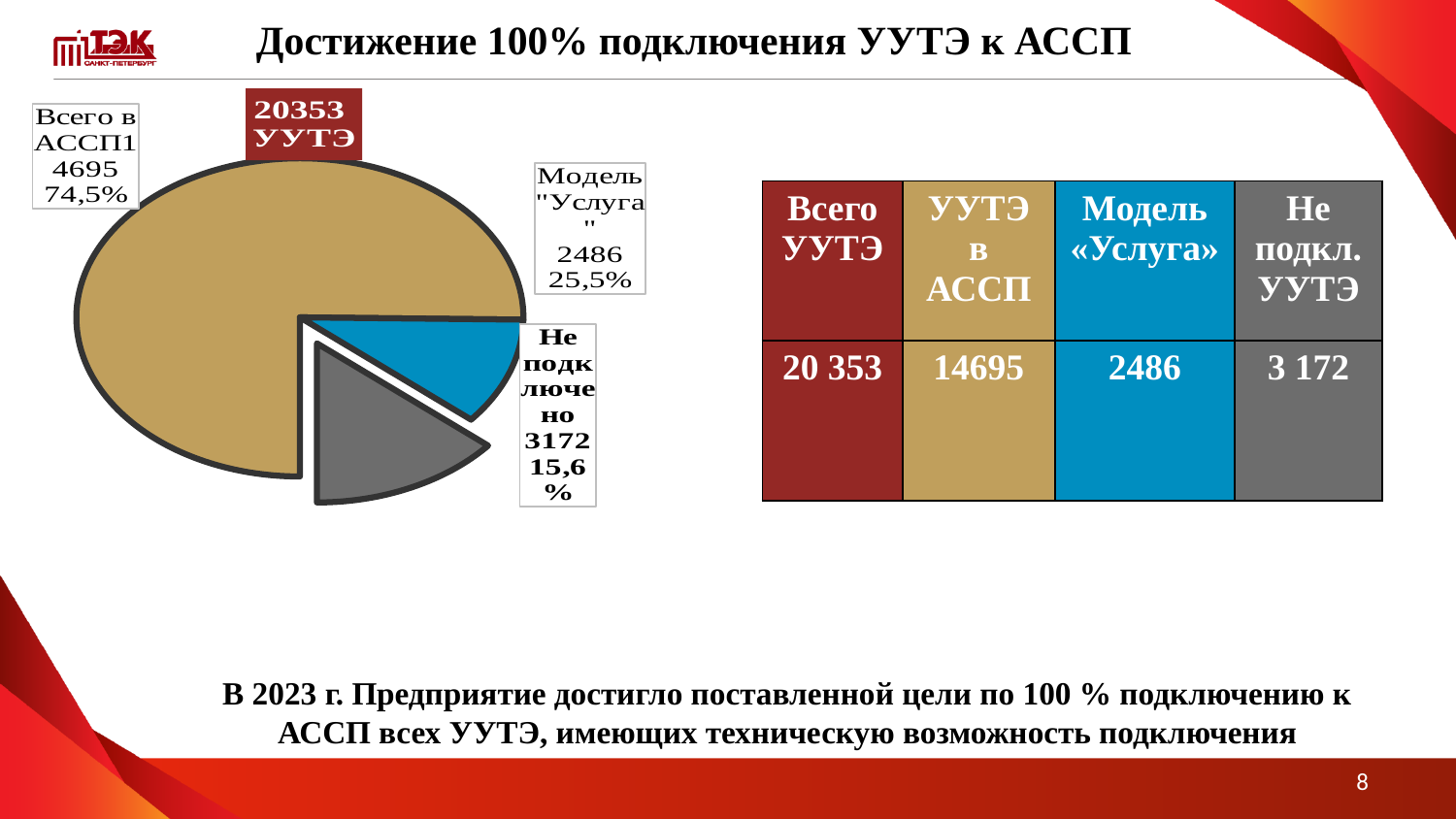
What percentage is shown for the slice "Не подключено" in the pie chart? 15,6% Which slice of the pie chart is the largest? Всего в АССП What value is shown for the slice "Не подключено" in the pie chart? 3172 What percentage is shown for the slice "Модель "Услуга"" in the pie chart? 25,5% What percentage is shown for the slice "Всего в АССП" in the pie chart? 74,5% Which slice of the pie chart is the smallest? Модель "Услуга" What value is shown for the slice "Всего в АССП" in the pie chart? 14695 What value is shown for the slice "Модель "Услуга"" in the pie chart? 2486 What total number of УУТЭ is shown in the label above the pie chart? 20353 УУТЭ How many slices does the pie chart have? 3 What kind of chart is shown on the slide? pie chart What is the difference between the values for "Не подключено" and "Модель "Услуга"" in the pie chart? 686